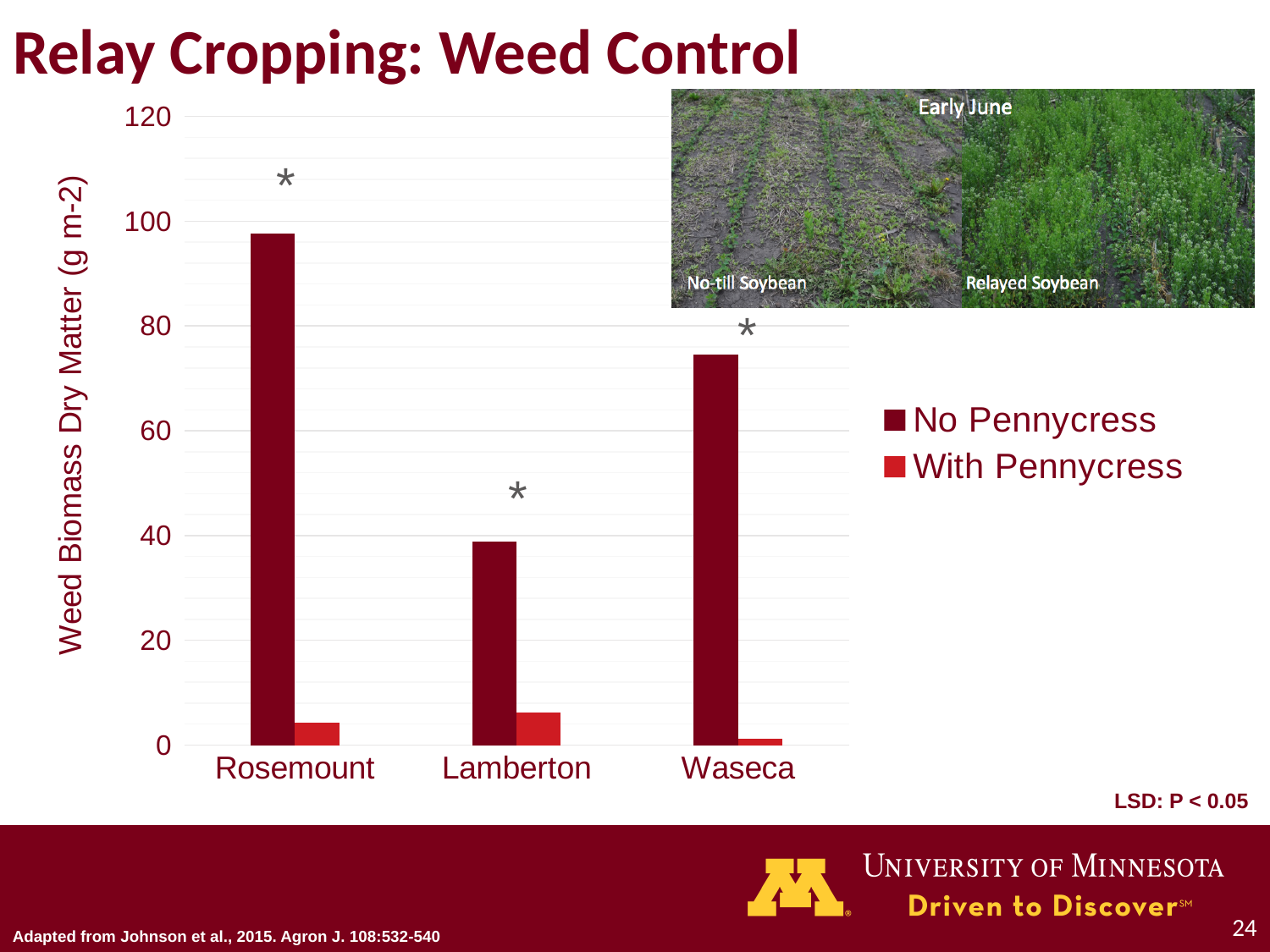
What is the label of the y axis? Weed Biomass Dry Matter (g m-2) What kind of chart is shown on the slide? bar chart Which is larger: the No Pennycress value for Waseca or the No Pennycress value for Lamberton? Waseca Is the No Pennycress value for Rosemount greater or less than 80? greater Which location has the highest No Pennycress weed biomass? Rosemount At Lamberton, which is larger: the No Pennycress value or the With Pennycress value? No Pennycress Which location has the lowest No Pennycress weed biomass? Lamberton How many locations are shown on the x axis? 3 Which location has the lowest With Pennycress weed biomass? Waseca Is the No Pennycress value for Waseca greater or less than 60? greater How many series does the legend list? 2